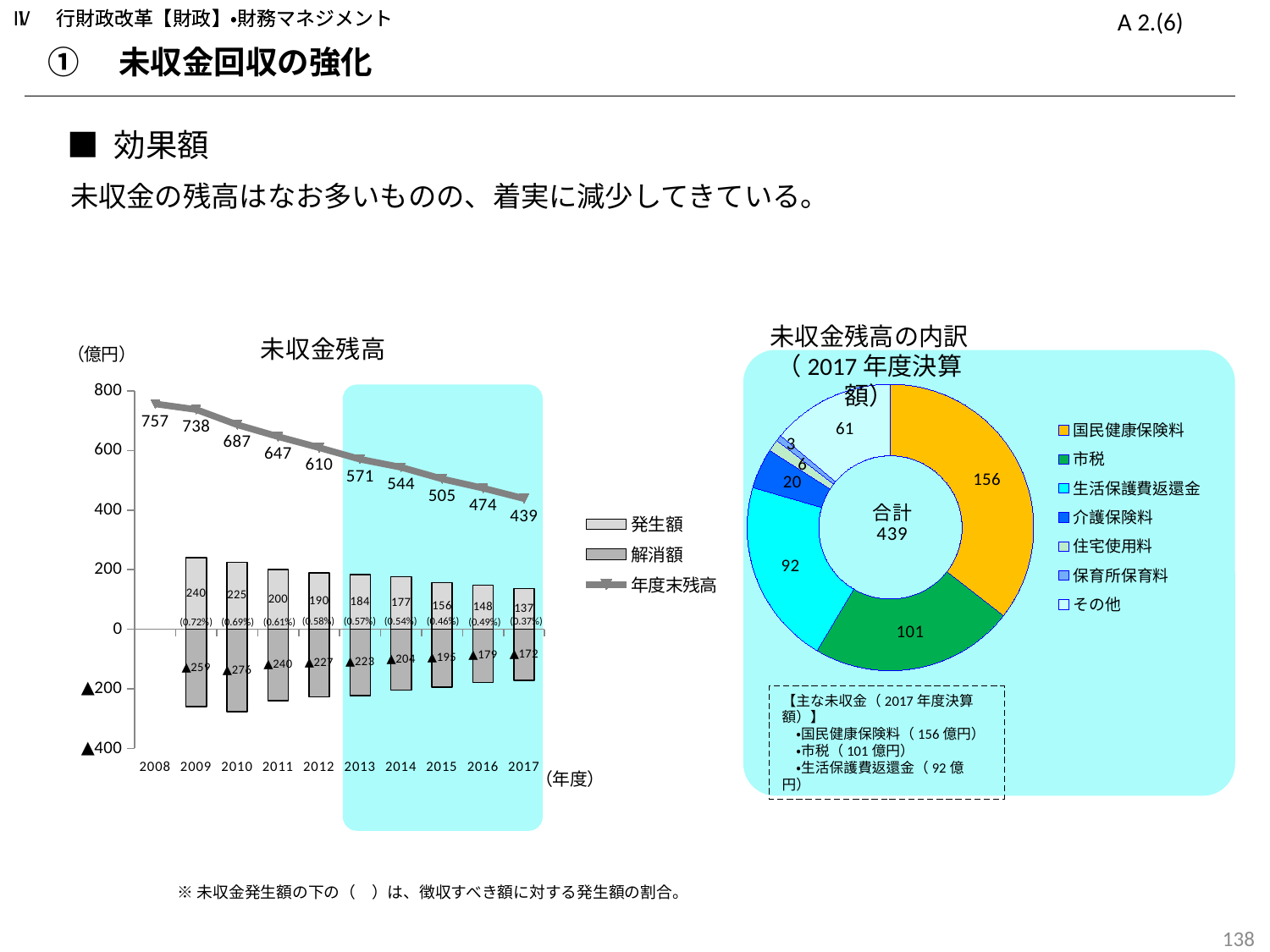
In the 未収金残高 chart, what is the difference between the 年度末残高 for 2008 and 2017? 318 In the 未収金残高の内訳 chart, which category has the largest value? 国民健康保険料 In the 未収金残高 chart, how many series does the legend list? 3 In the 未収金残高 chart, how many years are shown on the x axis? 10 What kind of chart is the 未収金残高の内訳 chart? donut (pie) chart In the 未収金残高 chart, does the 年度末残高 rise or fall from 2008 to 2017? fall In the 未収金残高 chart, which year has the highest 年度末残高? 2008 In the 未収金残高の内訳 chart, what is the value for 市税? 101 In the 未収金残高の内訳 chart, what is the total shown in the centre? 439 In the 未収金残高 chart, what is the 発生額 value for 2013? 184 In the 未収金残高 chart, what is the 解消額 value for 2010? ▲276 In the 未収金残高 chart, what is the 年度末残高 value for 2017? 439